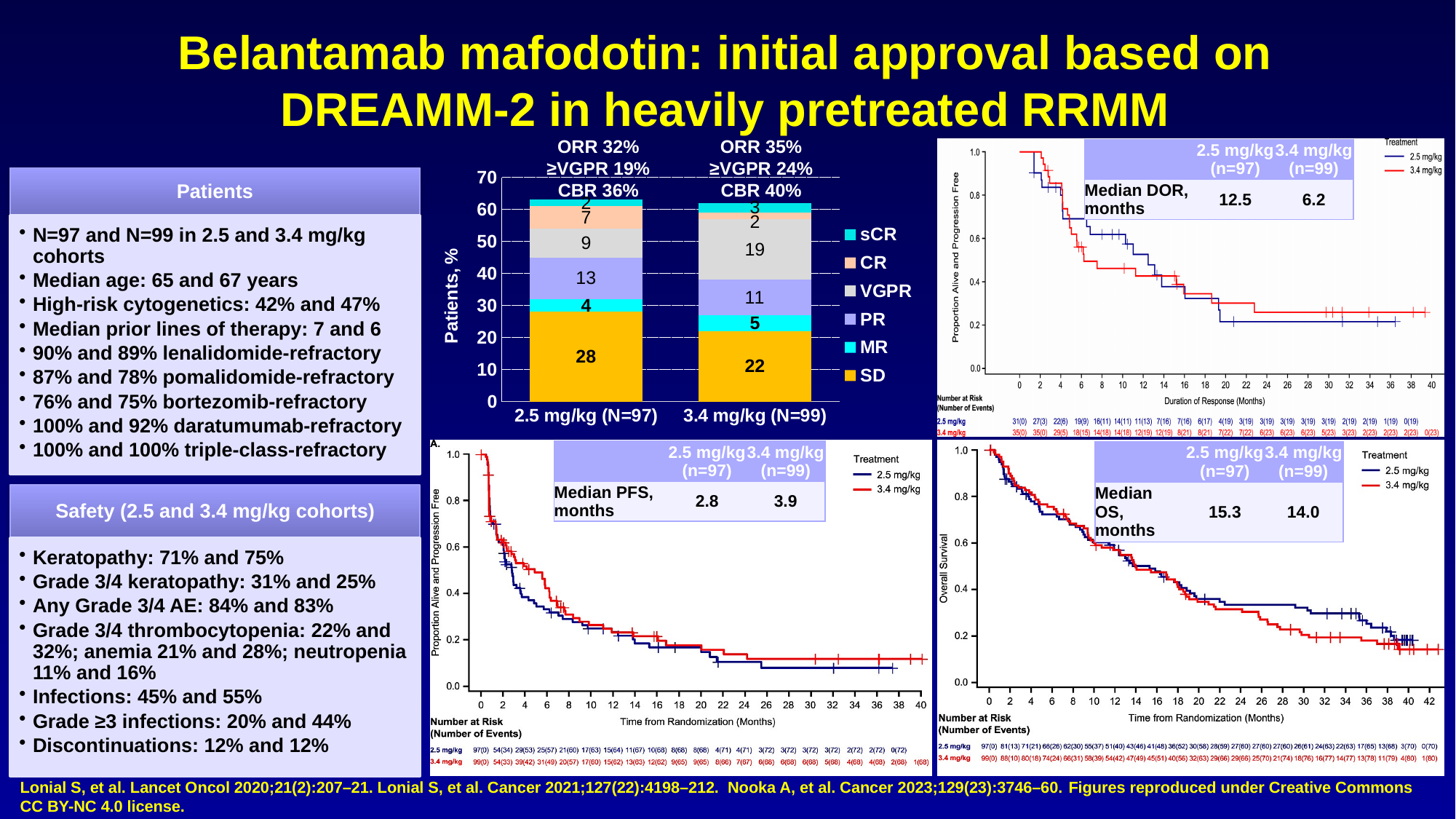
In the stacked bar chart of response rates, which cohort has the larger VGPR value, 2.5 mg/kg or 3.4 mg/kg? 3.4 mg/kg In the progression-free survival Kaplan-Meier chart (bottom middle), what is the median PFS in months for the 3.4 mg/kg cohort? 3.9 In the stacked bar chart of response rates, what is the VGPR value for the 3.4 mg/kg (N=99) cohort? 19 In the stacked bar chart of response rates, how many series does the legend list? 6 In the stacked bar chart of response rates, what is the difference between the SD values of the 2.5 mg/kg and 3.4 mg/kg cohorts? 6 In the overall survival Kaplan-Meier chart (bottom right), what is the median OS in months for the 2.5 mg/kg cohort? 15.3 What type of chart is used to show the response categories (sCR, CR, VGPR, PR, MR, SD)? Stacked bar chart In the duration of response Kaplan-Meier chart (top right), which cohort has the longer median DOR, 2.5 mg/kg or 3.4 mg/kg? 2.5 mg/kg In the stacked bar chart of response rates, what is the total of the stacked bar for the 2.5 mg/kg (N=97) cohort? 63 In the stacked bar chart of response rates, how many cohorts (bars) are shown on the x axis? 2 In the stacked bar chart of response rates, what is the SD value for the 2.5 mg/kg (N=97) cohort? 28 In the stacked bar chart of response rates, what is the PR value for the 2.5 mg/kg (N=97) cohort? 13